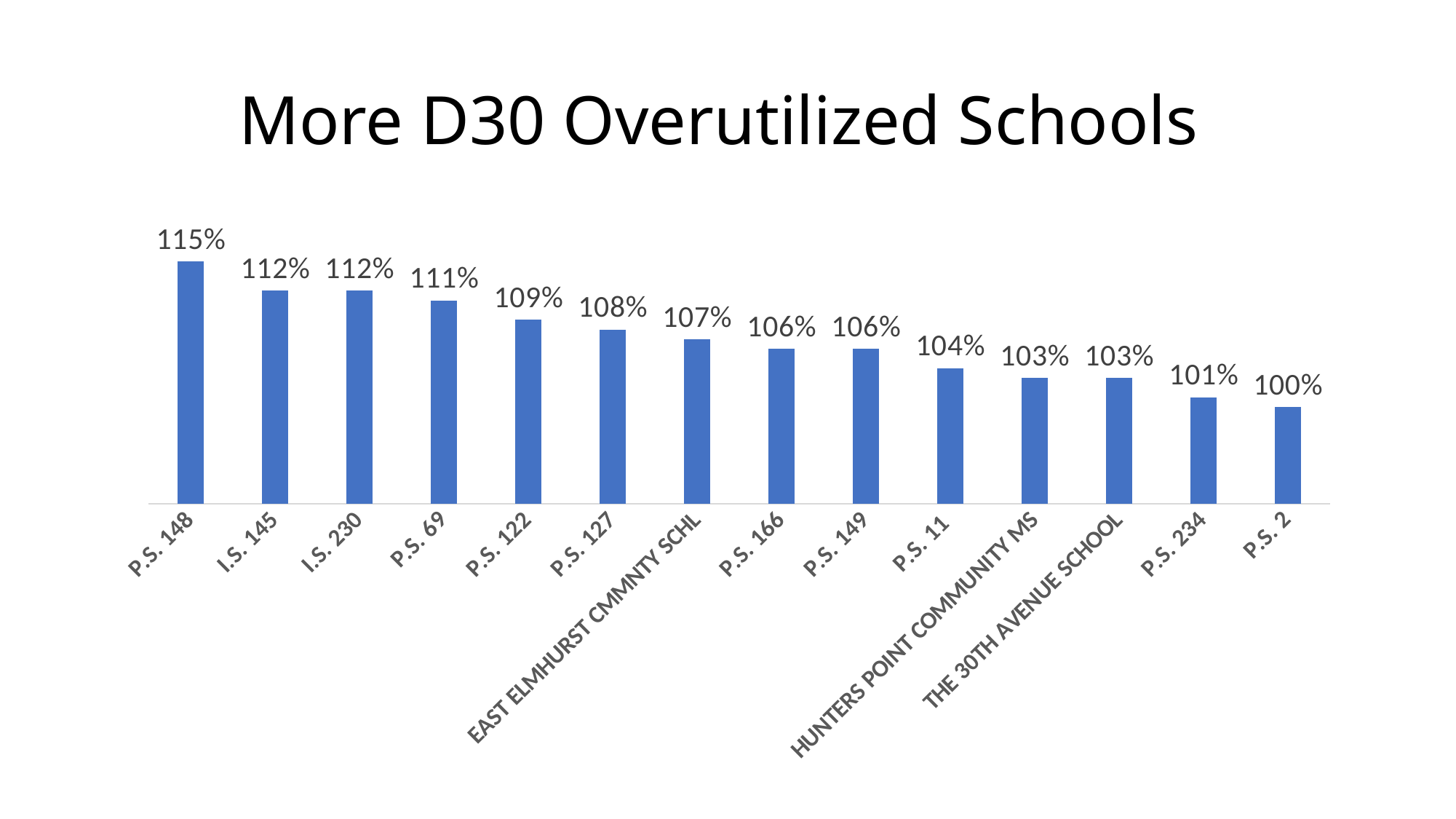
What is the value for Hunters Point Community MS? 103% Do the values rise or fall from left to right along the x axis? Fall What is the difference between the values for P.S. 69 and P.S. 11? 7% Which school has the lowest value? P.S. 2 What kind of chart is shown on the slide? Bar chart What is the value for P.S. 234? 101% Which school has the highest value? P.S. 148 Which is larger, the value for P.S. 122 or the value for P.S. 166? P.S. 122 What is the value for East Elmhurst Cmmnty Schl? 107% How many schools are shown in the chart? 14 What is the difference between the values for P.S. 148 and P.S. 2? 15% What is the value for P.S. 148? 115%